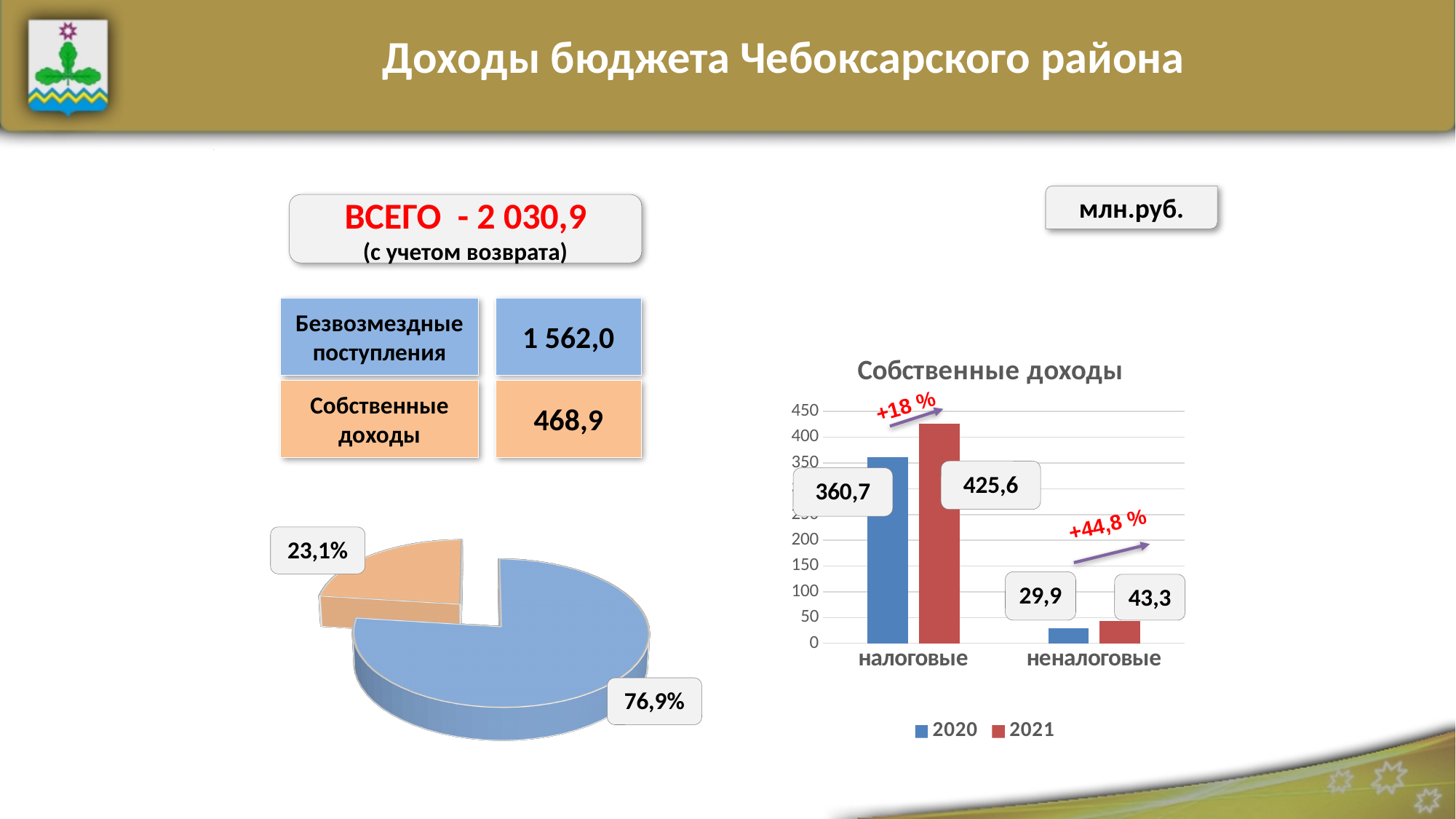
What kind of chart is the chart on the left of the slide? pie chart What kind of chart is the chart titled 'Собственные доходы'? bar chart On the bar chart titled 'Собственные доходы', what percentage change is annotated above the налоговые bars? +18 % On the bar chart titled 'Собственные доходы', which is larger: налоговые in 2020 or налоговые in 2021? налоговые in 2021 On the pie chart on the left of the slide, what share does the orange slice represent? 23,1% On the bar chart titled 'Собственные доходы', what is the value for налоговые in 2021? 425,6 On the bar chart titled 'Собственные доходы', what is the value for неналоговые in 2020? 29,9 On the bar chart titled 'Собственные доходы', what is the value for налоговые in 2020? 360,7 On the pie chart on the left of the slide, what share does the blue slice represent? 76,9% On the bar chart titled 'Собственные доходы', how many categories are shown on the x axis? 2 On the bar chart titled 'Собственные доходы', how many series does the legend list? 2 On the bar chart titled 'Собственные доходы', what is the difference between the 2021 and 2020 values for неналоговые? 13,4